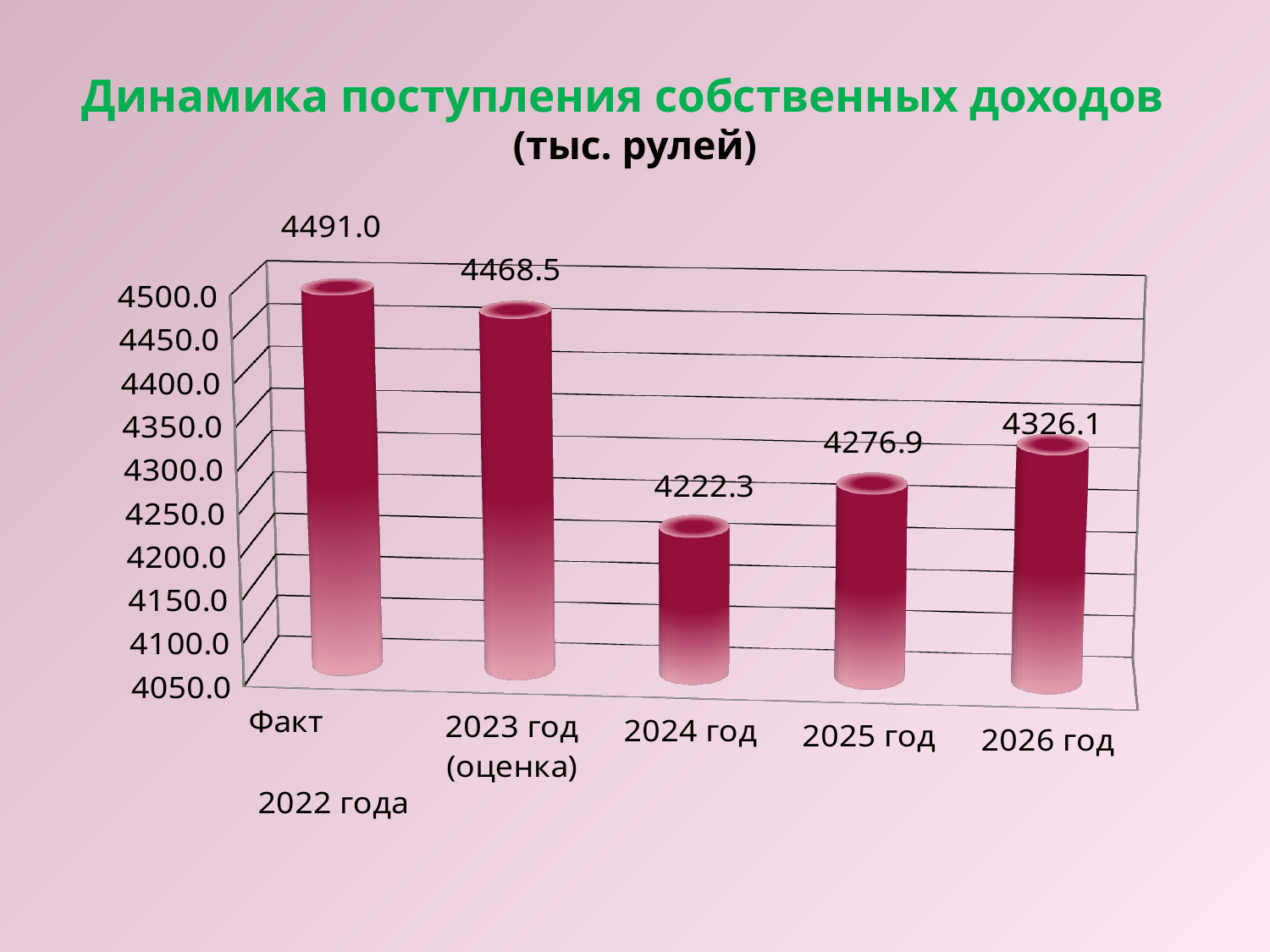
Which category has the highest value? Факт 2022 года What is the value for 2023 год (оценка)? 4468.5 Which category has the lowest value? 2024 год How many categories are shown on the chart? 5 What is the title of the chart? Динамика поступления собственных доходов (тыс. рулей) Which is larger, the value for 2025 год or the value for 2026 год? 2026 год What is the difference between the values for Факт 2022 года and 2023 год (оценка)? 22.5 What is the difference between the values for 2026 год and 2025 год? 49.2 What is the value for 2024 год? 4222.3 What is the value for 2026 год? 4326.1 What is the value for Факт 2022 года? 4491.0 What kind of chart is shown on the slide? Bar chart